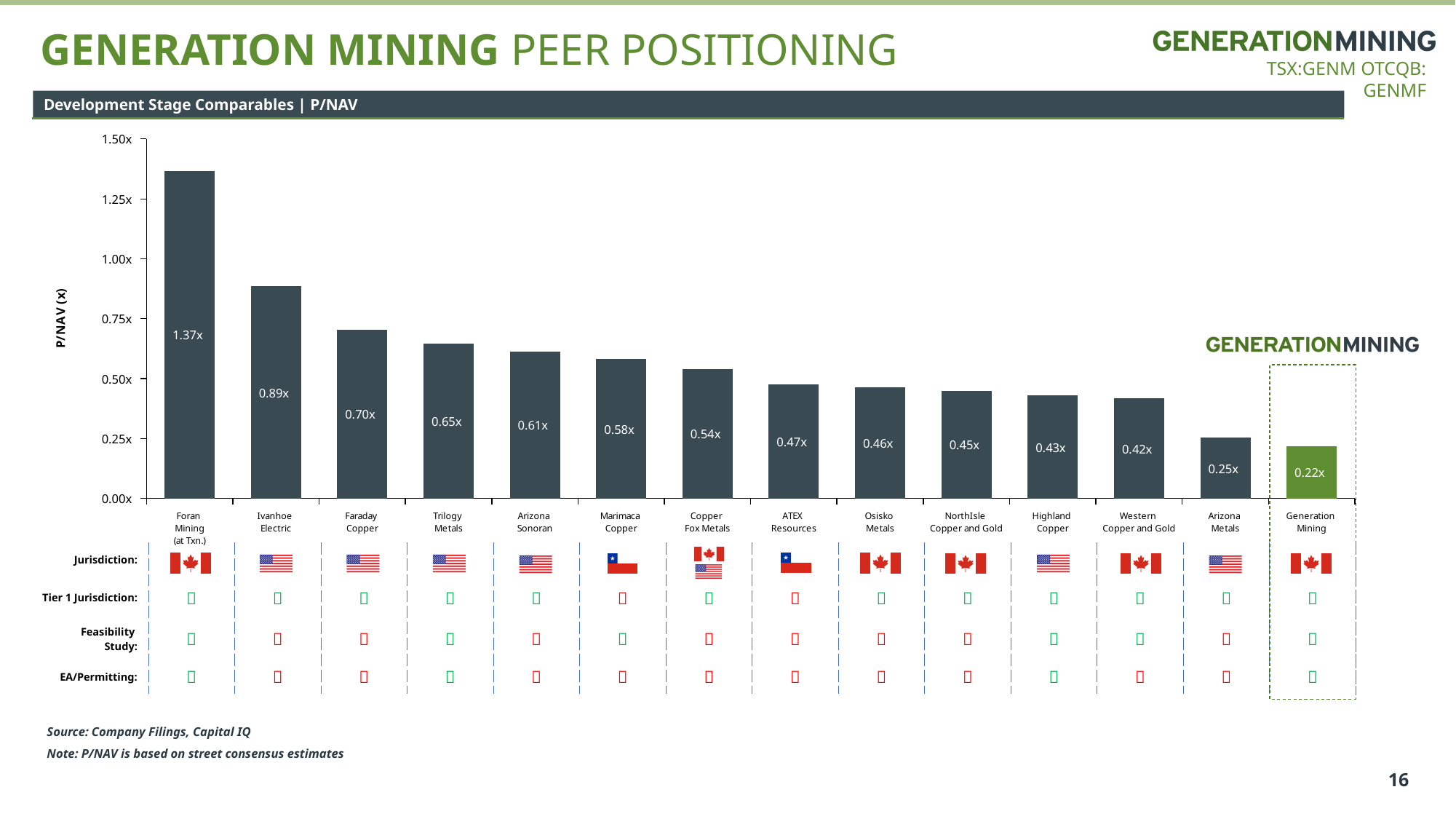
Which company has the highest P/NAV in the chart? Foran Mining (at Txn.) What is the difference in P/NAV between Ivanhoe Electric and Faraday Copper? 0.19x Which has a higher P/NAV, Trilogy Metals or Arizona Metals? Trilogy Metals What is the P/NAV value for Generation Mining? 0.22x Is the P/NAV value for Ivanhoe Electric greater or less than 0.75x? greater How many companies are shown in the chart? 14 What type of chart is shown on the slide? Bar chart What is the P/NAV value for Marimaca Copper? 0.58x What is the P/NAV value for Foran Mining (at Txn.)? 1.37x Do the P/NAV values rise or fall from left to right across the chart? Fall Which company has the lowest P/NAV in the chart? Generation Mining What is the label of the y-axis of the chart? P/NAV (x)